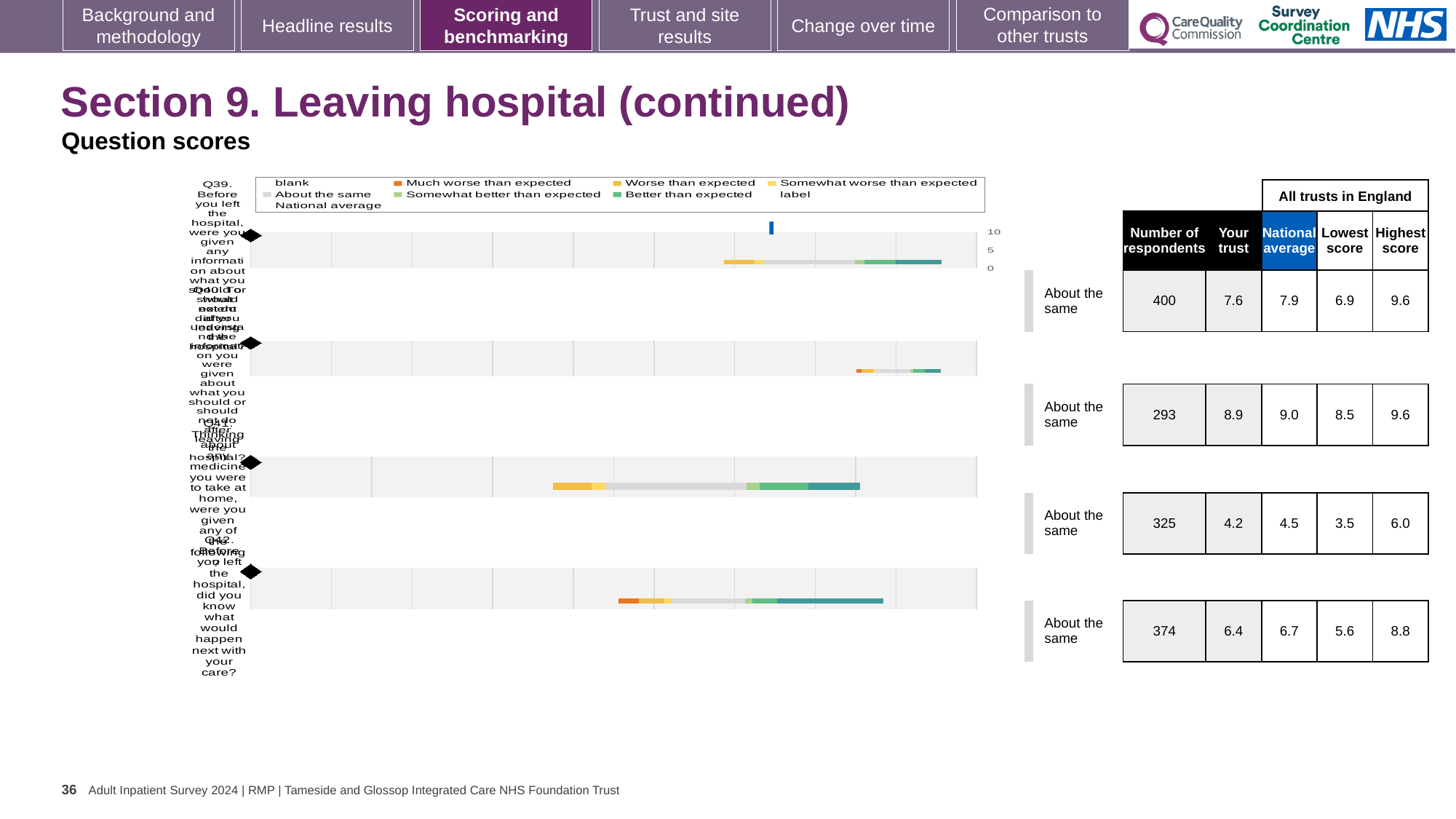
For the top chart (Q39), what is the 'Your trust' score shown in the table? 7.6 How many entries does the legend above the charts list? 9 For the top chart (Q39), what is the difference between the highest score and the lowest score across all trusts in England? 2.7 What kind of chart is used to show the question scores on this slide? bar chart What benchmark label is shown next to each of the four charts? About the same For the top chart (Q39), what is the national average score shown in the table? 7.9 For the top chart (Q39), which is larger: the 'Your trust' score or the national average? National average How many benchmark bar charts are shown on the slide? 4 What colour does the legend use for 'Much worse than expected'? orange Across the four charts, what is the lowest 'Your trust' score shown in the table? 4.2 For the bottom chart (Q42, did you know what would happen next with your care), what is the 'Your trust' score shown in the table? 6.4 For the top chart (Q39, information about what you should or should not do after leaving hospital), what is the number of respondents shown in the table? 400